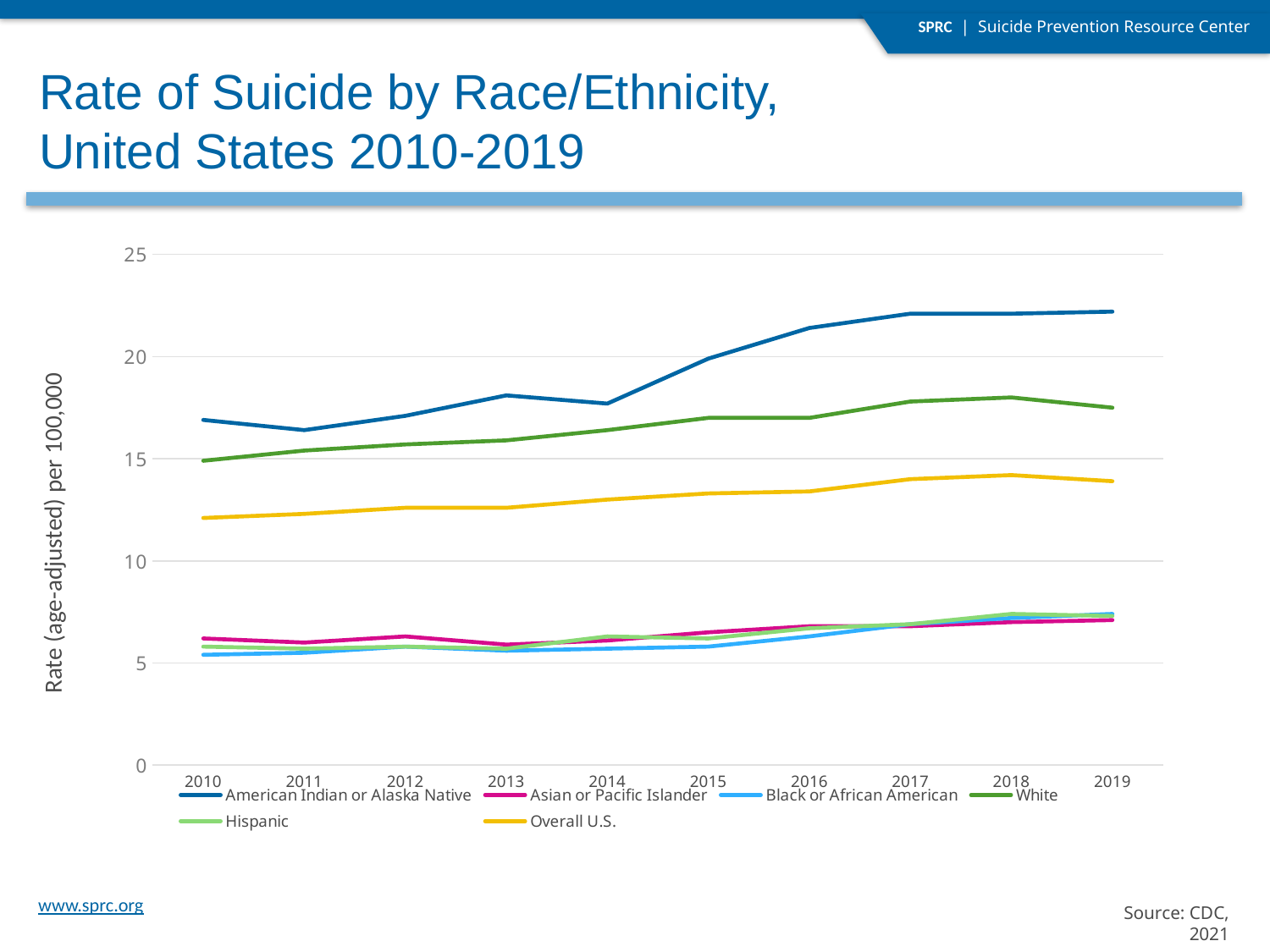
What kind of chart is shown on the slide? line chart Which race/ethnicity group has the highest suicide rate in 2019? American Indian or Alaska Native How many series does the legend list? 6 Does the rate for American Indian or Alaska Native rise or fall from 2010 to 2019? rise Is the value for Black or African American in 2010 greater or less than 10? less What is the label on the y axis of the chart? Rate (age-adjusted) per 100,000 How many years are shown along the x axis? 10 Is the value for American Indian or Alaska Native in 2019 greater or less than 20? greater Is the value for White in 2018 greater or less than 15? greater In 2010, which is larger: the rate for Asian or Pacific Islander or the rate for Black or African American? Asian or Pacific Islander In 2015, which is larger: the rate for White or the rate for Overall U.S.? White